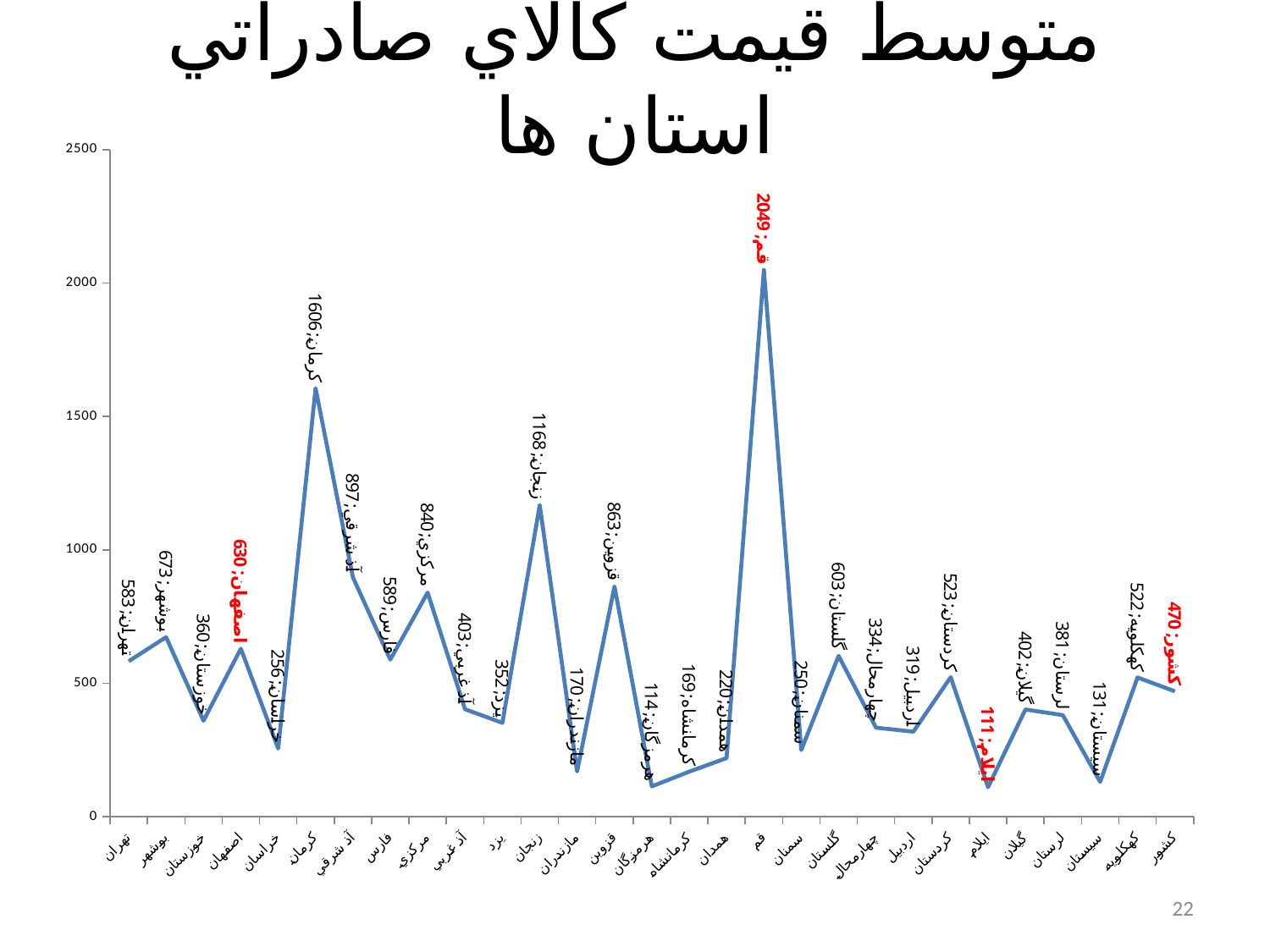
Is the value for آذ شرقي greater or less than 1000? less How many categories are plotted along the x axis? 29 Which is larger, the value for زنجان or the value for قزوين? زنجان Which category has the highest value? قم What is the value for كرمان? 1606 What is the value for قم? 2049 What is the value for كشور? 470 What is the value for اصفهان? 630 What is the difference between the values for قم and كرمان? 443 What is the difference between the values for تهران and بوشهر? 90 What type of chart is shown on the slide? line chart Which category has the lowest value? ايلام